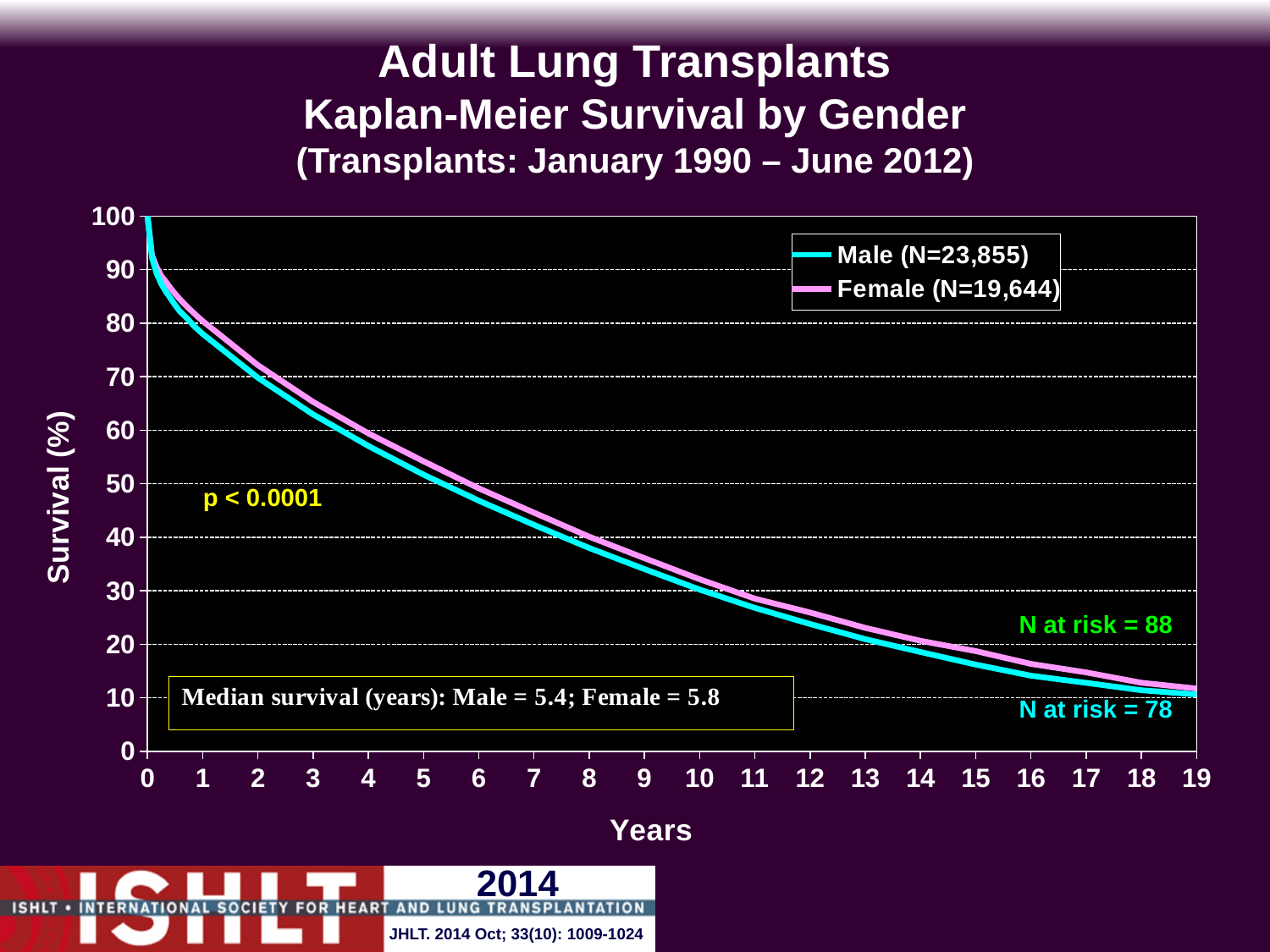
What is the number of female transplant recipients (N) given in the legend? 19,644 What is the median survival in years for females? 5.8 What is the difference in median survival (years) between females and males? 0.4 Which gender has the longer median survival? Female How many series does the legend list? 2 Do the survival curves rise or fall as years increase? fall What p-value is shown on the chart? p < 0.0001 What is the number of male transplant recipients (N) given in the legend? 23,855 What is the median survival in years for males? 5.4 What kind of chart is shown on the slide? line chart